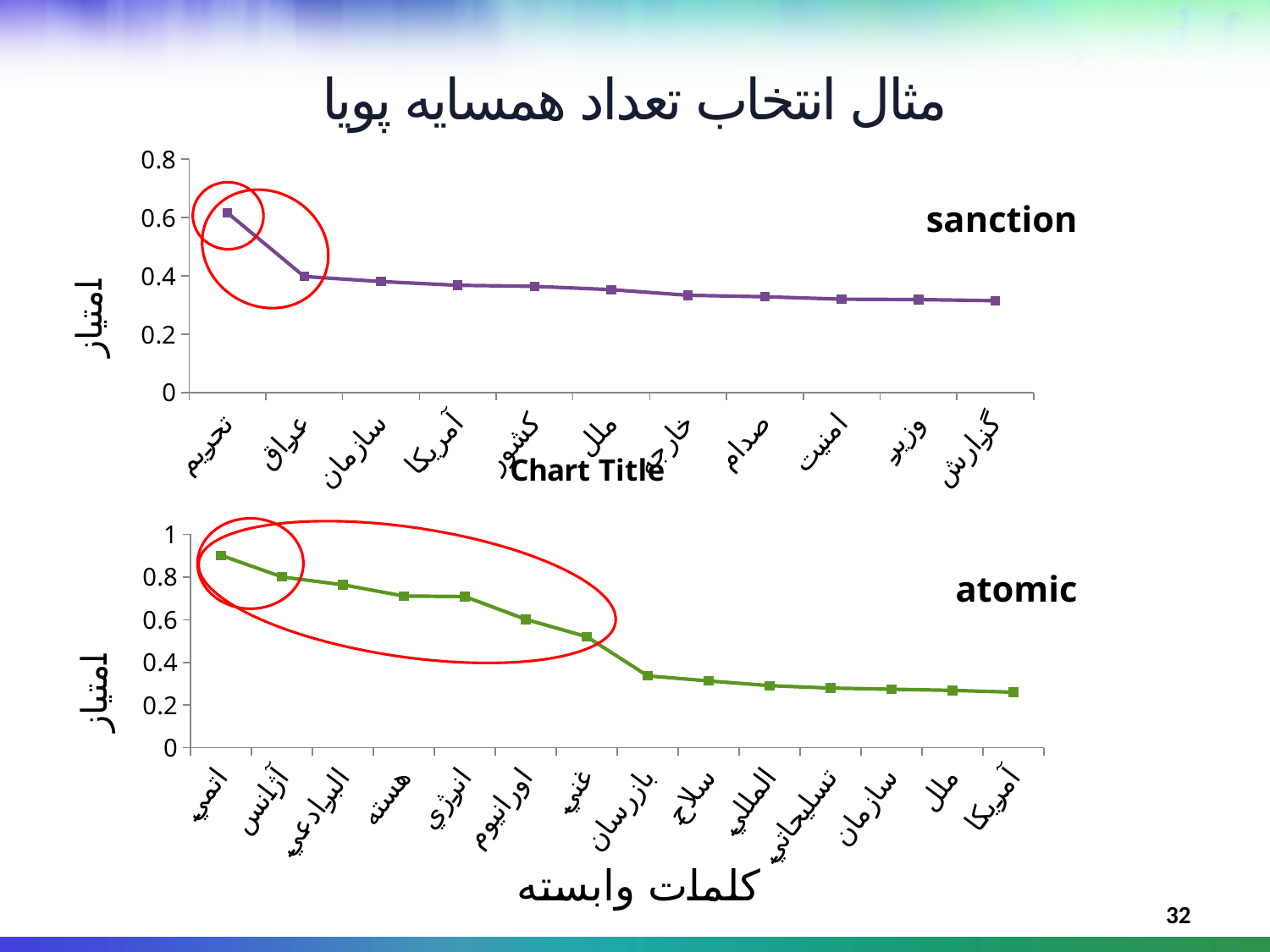
What is the x-axis label of the bottom chart labelled "atomic"? کلمات وابسته In the top chart labelled "sanction", is the value for گزارش greater or less than 0.4? less In the top chart labelled "sanction", is the value for تحریم greater or less than 0.4? greater In the bottom chart labelled "atomic", do the values rise or fall from left to right along the x axis? fall In the bottom chart labelled "atomic", is the value for بازرسان greater or less than 0.4? less What kind of chart is the top chart labelled "sanction"? line chart In the bottom chart labelled "atomic", which has the larger value, اتمی or بازرسان? اتمی In the bottom chart labelled "atomic", how many categories are shown on the x axis? 14 In the bottom chart labelled "atomic", which category has the highest value? اتمی In the top chart labelled "sanction", which category has the highest value? تحریم In the top chart labelled "sanction", how many categories are shown on the x axis? 11